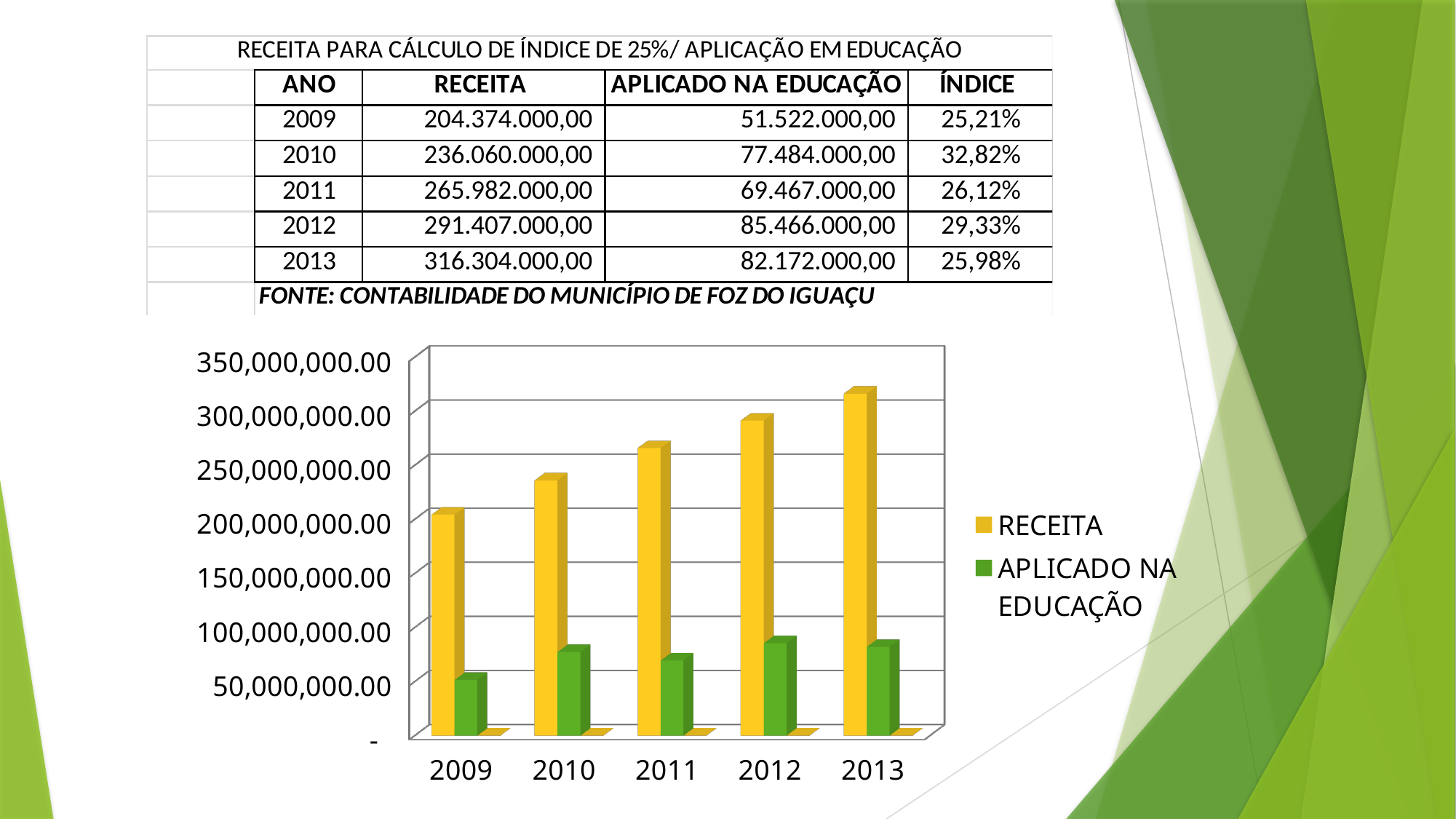
Is the RECEITA value for 2011 greater or less than 250,000,000.00? greater Which is larger, the APLICADO NA EDUCAÇÃO value for 2010 or for 2011? 2010 Which year has the lowest APLICADO NA EDUCAÇÃO bar? 2009 Which year has the highest RECEITA bar? 2013 How many years are shown on the x axis of the chart? 5 What kind of chart is shown on the slide? bar chart What colour represents RECEITA in the chart legend? yellow Is the APLICADO NA EDUCAÇÃO value for 2012 greater or less than 100,000,000.00? less Do the RECEITA values rise or fall from 2009 to 2013? rise How many series does the chart legend list? 2 Is the RECEITA value for 2010 greater or less than 250,000,000.00? less Which year has the lowest RECEITA bar? 2009